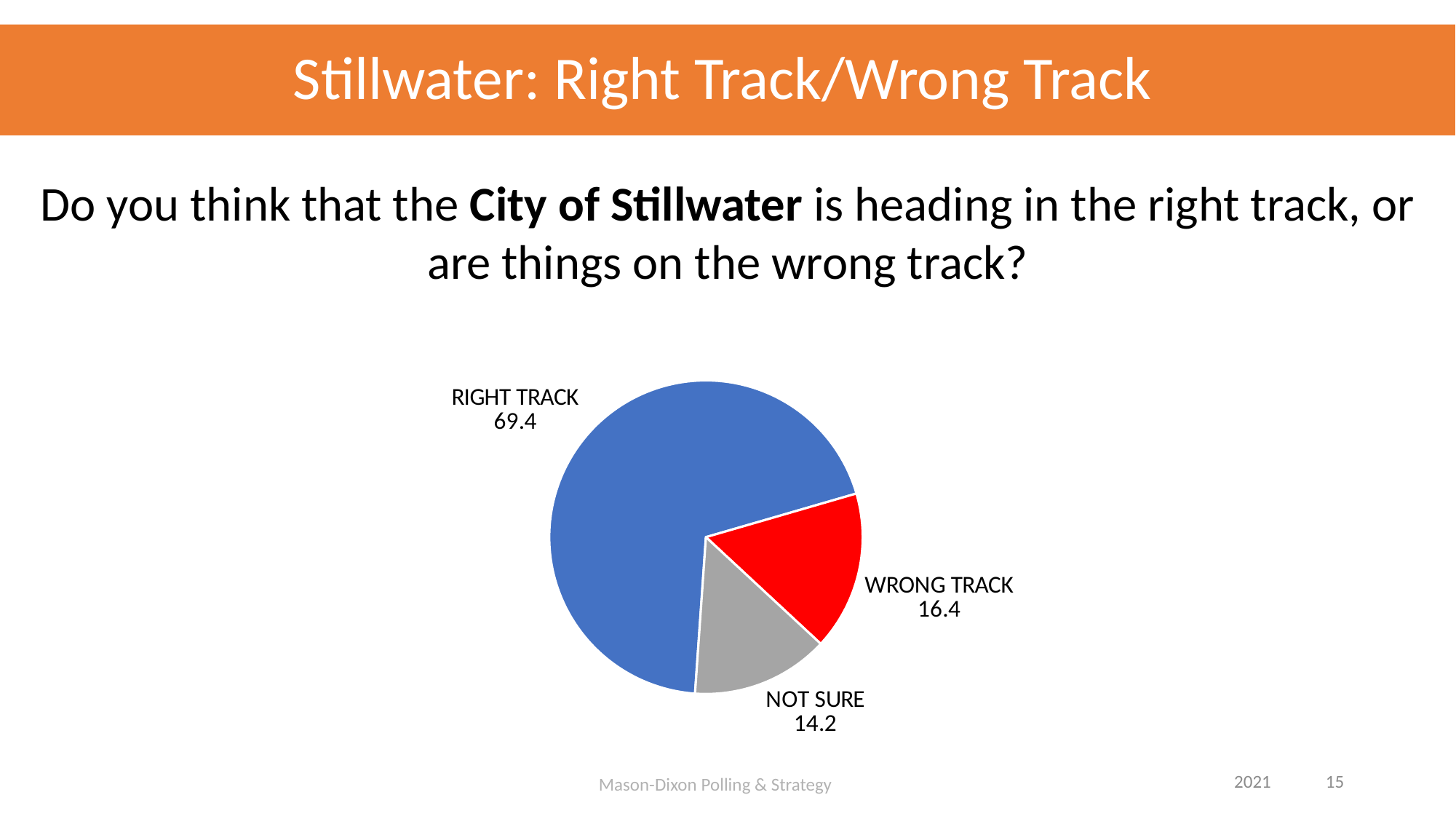
Which is larger, RIGHT TRACK or WRONG TRACK? RIGHT TRACK What value is shown for NOT SURE? 14.2 What is the difference between the RIGHT TRACK and WRONG TRACK values? 53.0 What value is shown for RIGHT TRACK? 69.4 What is the difference between the WRONG TRACK and NOT SURE values? 2.2 What kind of chart is shown on the slide? pie chart Which slice of the pie is the smallest? NOT SURE How many slices does the pie chart have? 3 What value is shown for WRONG TRACK? 16.4 Which slice of the pie is the largest? RIGHT TRACK What colour is the RIGHT TRACK slice? blue What colour is the WRONG TRACK slice? red